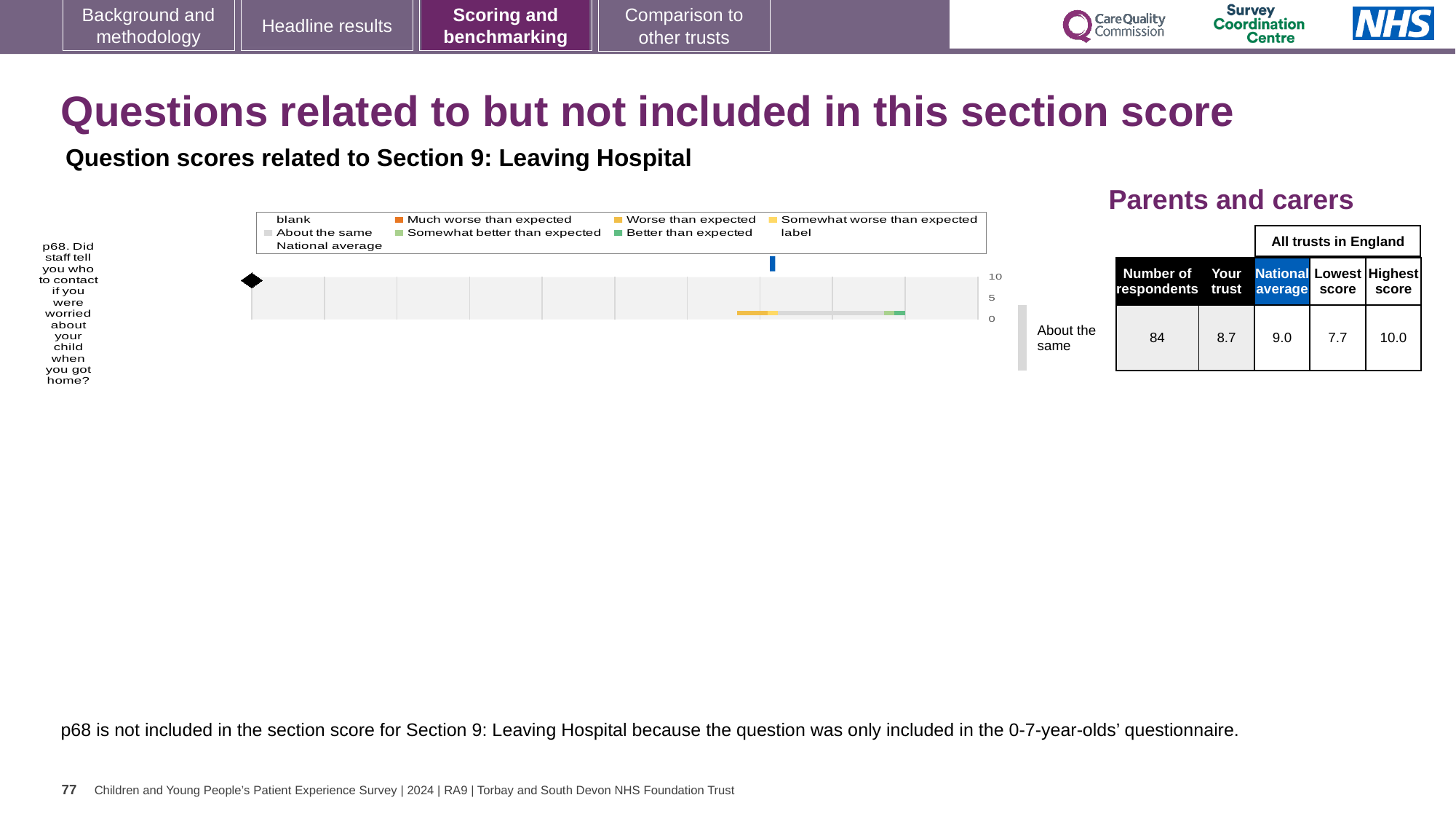
What kind of chart is shown on the slide? bar chart What is the lowest score among all trusts in England for p68? 7.7 What benchmark category is the trust's p68 score placed in? About the same How many respondents answered p68? 84 Which legend entry is shown in orange? Much worse than expected Which is larger for p68, the 'Your trust' score or the national average? National average What is the 'Your trust' score for p68 shown in the table next to the chart? 8.7 How many questions (categories) are plotted on the chart? 1 What is the national average score for p68 shown in the table next to the chart? 9.0 What is the highest score among all trusts in England for p68? 10.0 Which question is plotted on the chart? p68. Did staff tell you who to contact if you were worried about your child when you got home? What is the difference between the highest score and the lowest score for p68? 2.3